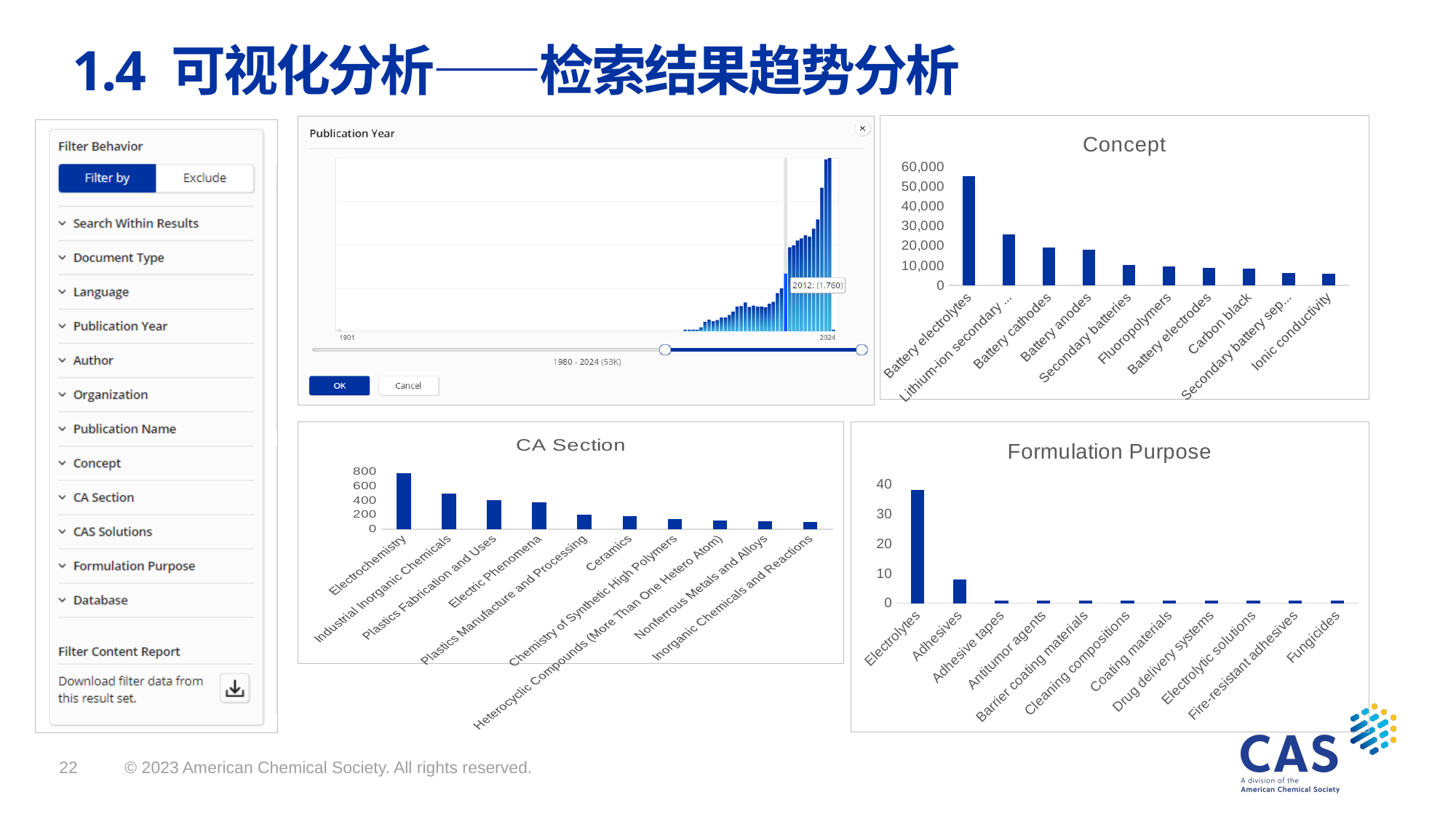
In the CA Section chart, is the value for Electrochemistry greater or less than 600? greater In the CA Section chart, which is larger: Industrial Inorganic Chemicals or Plastics Fabrication and Uses? Industrial Inorganic Chemicals How many categories are shown in the Concept chart? 10 In the Formulation Purpose chart, which category has the highest value? Electrolytes In the Publication Year chart, what value does the tooltip show for 2012? 1,760 What kind of chart is the Formulation Purpose chart? bar chart In the CA Section chart, which category has the highest value? Electrochemistry In the Concept chart, which category has the highest value? Battery electrolytes In the Concept chart, which is larger: Lithium-ion secondary ... or Battery cathodes? Lithium-ion secondary ... In the Publication Year chart, do the bars generally rise or fall from 1980 toward 2024? rise In the Formulation Purpose chart, is the value for Adhesives greater or less than 10? less In the Concept chart, is the value for Battery electrolytes greater or less than 50,000? greater